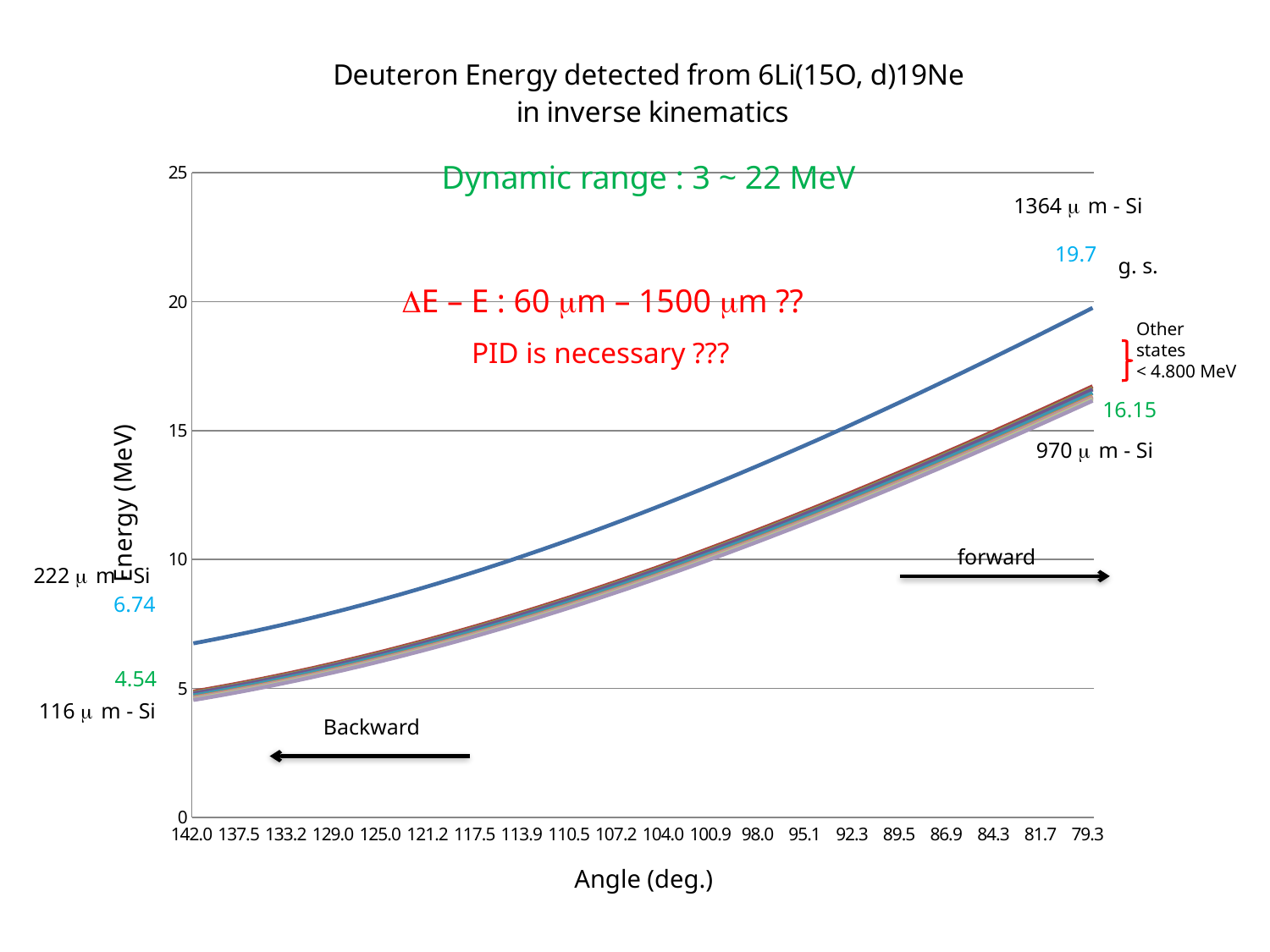
What is the deuteron energy of the other states lines at 142.0 degrees? 4.54 What is the deuteron energy of the other states lines at 79.3 degrees? 16.15 What is the deuteron energy of the g. s. line at 79.3 degrees? 19.7 What is the label of the x axis? Angle (deg.) Which line has the higher energy at 79.3 degrees, g. s. or the other states? g. s. Is the g. s. energy at 125.0 degrees greater or less than 10? less Do the energy values rise or fall moving from left to right along the x axis? rise What kind of chart is shown on the slide? line chart What is the difference between the g. s. energy at 79.3 degrees and at 142.0 degrees? 12.96 Is the g. s. energy at 100.9 degrees greater or less than 10? greater What is the deuteron energy of the g. s. line at 142.0 degrees? 6.74 What is the label of the y axis? Energy (MeV)